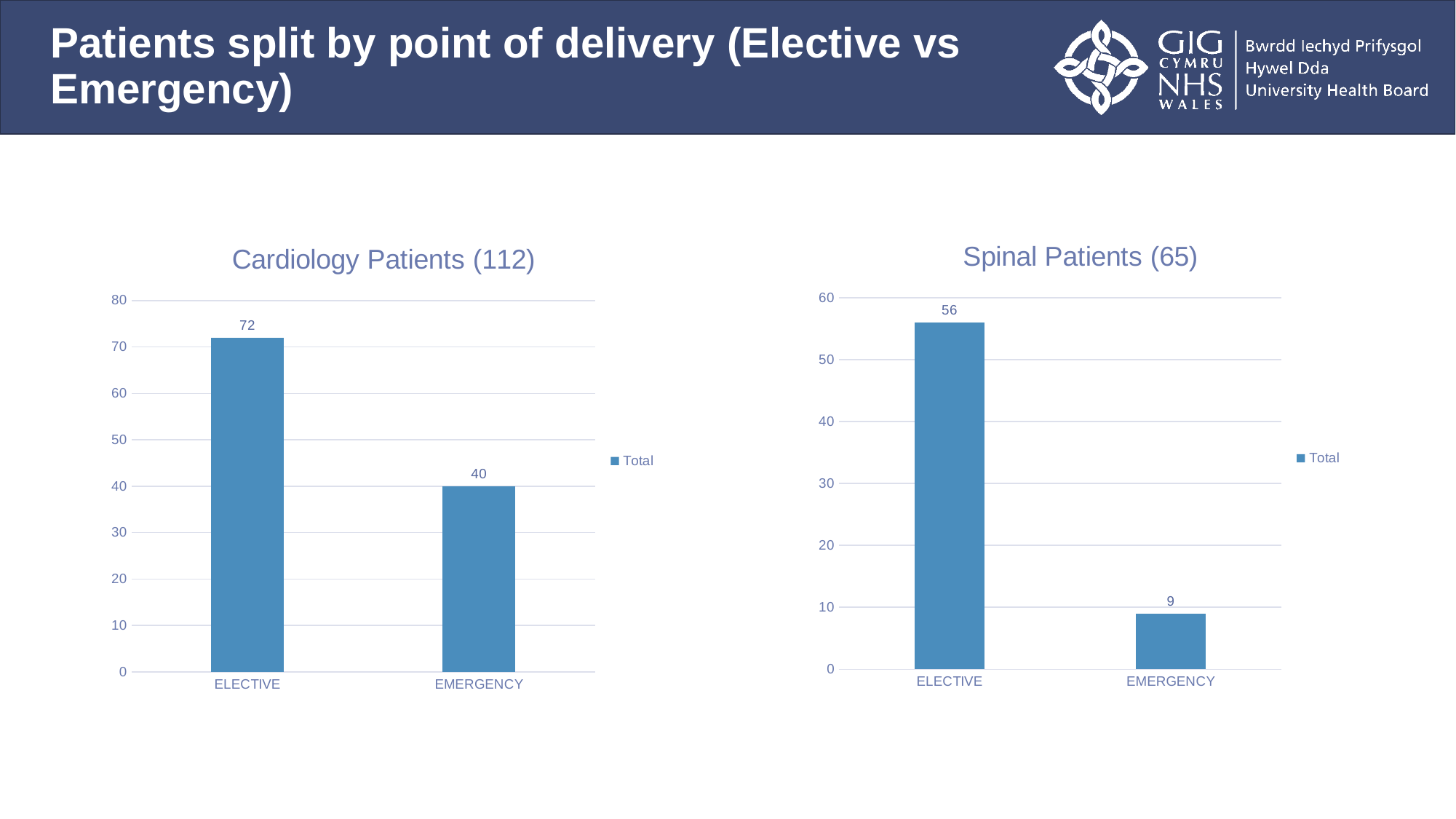
In the Spinal Patients (65) chart, what is the value for ELECTIVE? 56 In the Cardiology Patients (112) chart, what is the value for EMERGENCY? 40 Which is larger: the EMERGENCY value in the Cardiology Patients (112) chart or the EMERGENCY value in the Spinal Patients (65) chart? Cardiology Patients (112) In the Spinal Patients (65) chart, what is the value for EMERGENCY? 9 How many series does the legend of the Spinal Patients (65) chart list? 1 What kind of chart is the Cardiology Patients (112) chart? Bar chart In the Cardiology Patients (112) chart, what is the value for ELECTIVE? 72 How many categories are shown in the Spinal Patients (65) chart? 2 In the Cardiology Patients (112) chart, what is the difference between the ELECTIVE and EMERGENCY values? 32 In the Spinal Patients (65) chart, which category has the lowest value? EMERGENCY In the Cardiology Patients (112) chart, which category has the highest value? ELECTIVE In the Spinal Patients (65) chart, what is the difference between the ELECTIVE and EMERGENCY values? 47